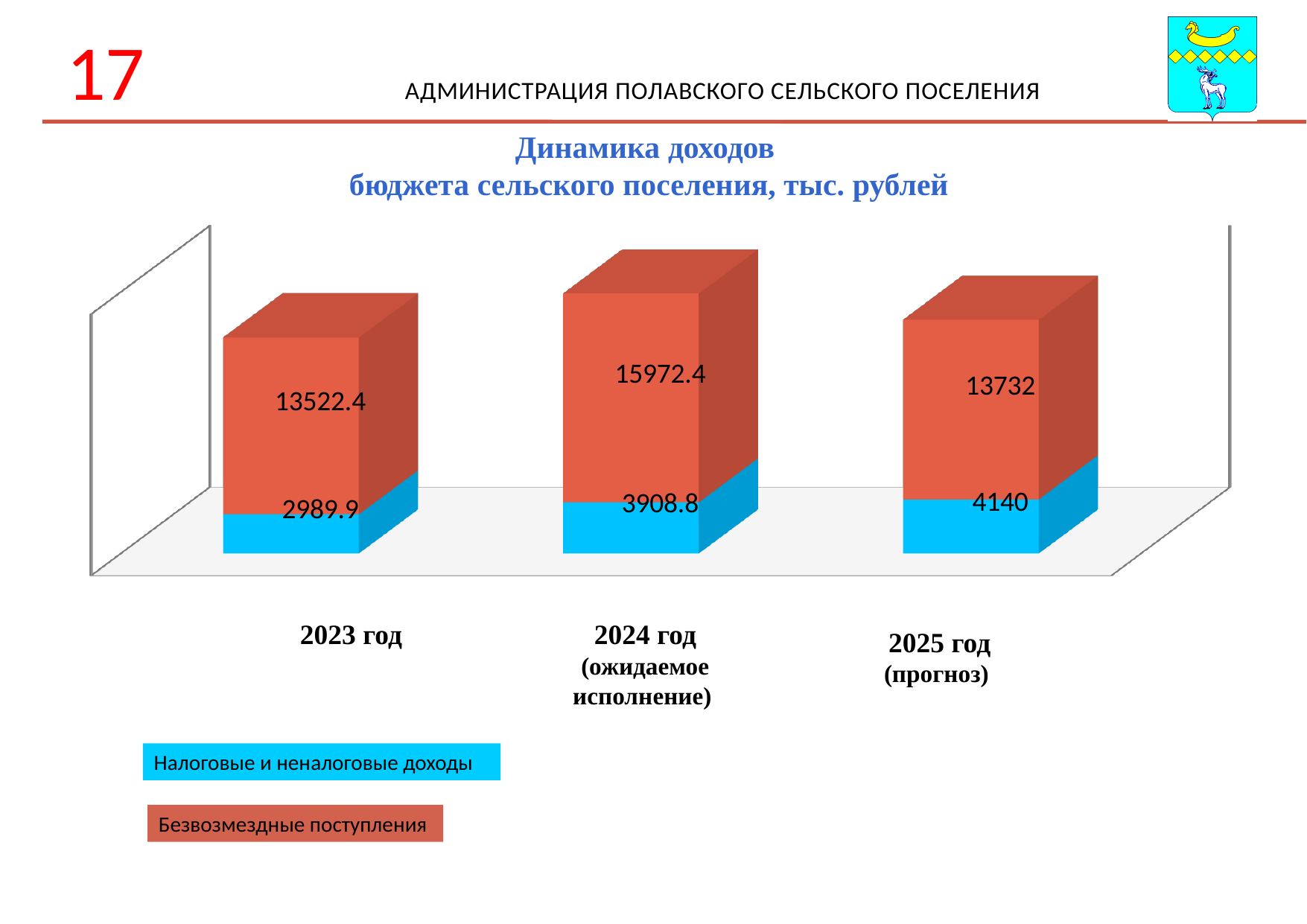
What is the value of Безвозмездные поступления for 2024 год (ожидаемое исполнение)? 15972.4 What is the value of Налоговые и неналоговые доходы for 2023 год? 2989.9 How many years (categories) are shown on the chart? 3 What type of chart is shown on the slide? Stacked bar chart How many series does the legend list? 2 Which is larger: Налоговые и неналоговые доходы in 2025 год or in 2024 год? 2025 год In which year is Безвозмездные поступления highest? 2024 год (ожидаемое исполнение) What is the total of the stacked bar for 2025 год (прогноз)? 17872 What is the value of Налоговые и неналоговые доходы for 2025 год (прогноз)? 4140 Which colour represents Безвозмездные поступления in the chart? Red In which year is Налоговые и неналоговые доходы lowest? 2023 год What is the difference in Безвозмездные поступления between 2024 год and 2023 год? 2450